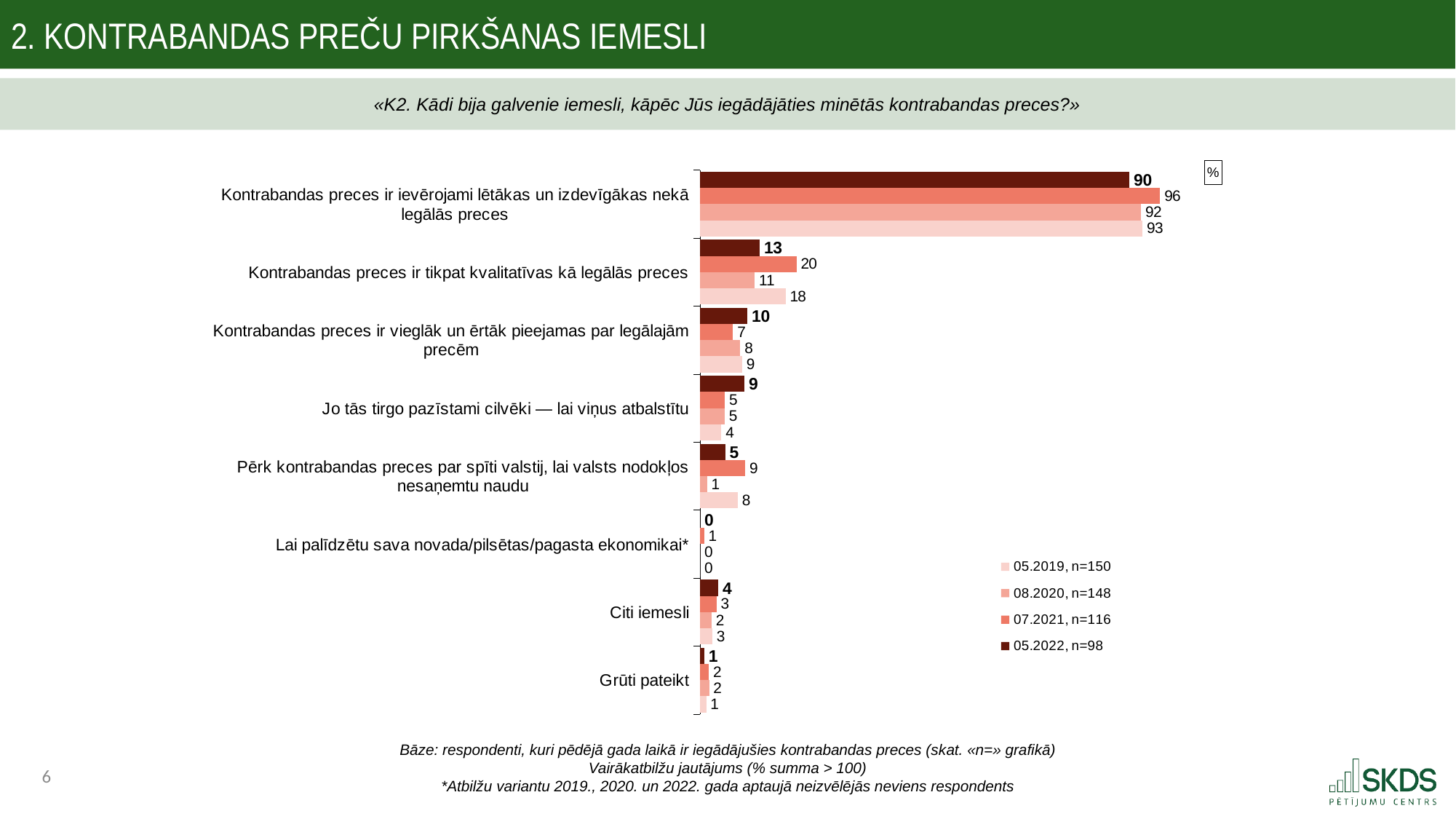
How many series does the legend list? 4 For 'Jo tās tirgo pazīstami cilvēki — lai viņus atbalstītu', which survey has the larger value: 05.2022 or 05.2019? 05.2022 What is the difference between the 07.2021 and 05.2022 values for 'Kontrabandas preces ir ievērojami lētākas un izdevīgākas nekā legālās preces'? 6 What is the value for 'Pērk kontrabandas preces par spīti valstij, lai valsts nodokļos nesaņemtu naudu' in the 08.2020 survey? 1 What is the sample size (n) shown in the legend for the 05.2022 survey? n=98 What kind of chart is shown on the slide? bar chart Which category has the highest value in the 05.2022 series? Kontrabandas preces ir ievērojami lētākas un izdevīgākas nekā legālās preces Which category has the lowest value in the 05.2022 series? Lai palīdzētu sava novada/pilsētas/pagasta ekonomikai* How many reason categories are plotted on the chart? 8 What is the value for 'Kontrabandas preces ir tikpat kvalitatīvas kā legālās preces' in the 07.2021 survey? 20 What is the value for 'Kontrabandas preces ir ievērojami lētākas un izdevīgākas nekā legālās preces' in the 05.2022 survey? 90 What is the value for 'Citi iemesli' in the 05.2019 survey? 3